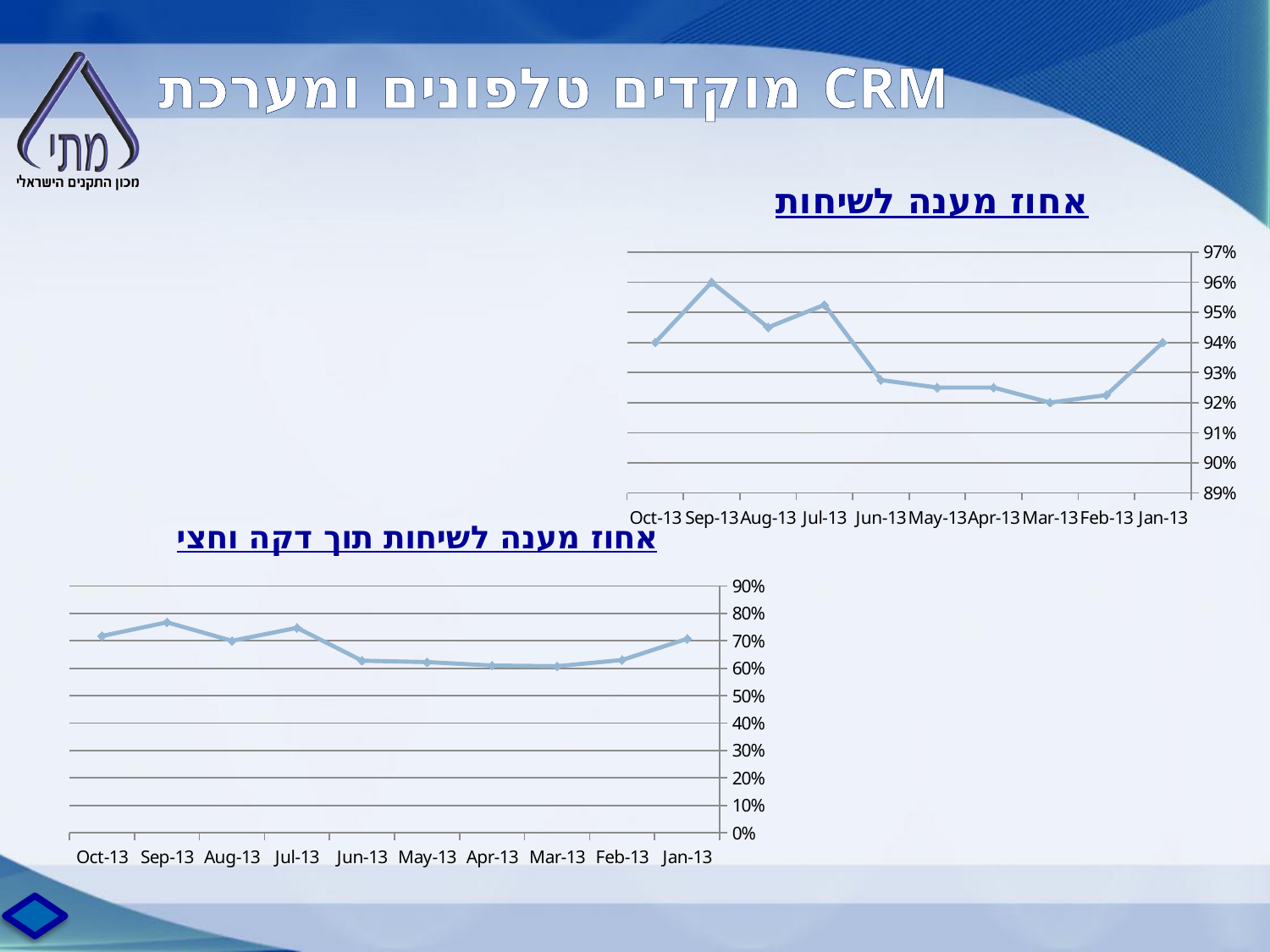
In the top chart (אחוז מענה לשיחות), does the value rise or fall from Jul-13 to Jun-13? fall What is the highest value shown on the vertical axis of the bottom chart (אחוז מענה לשיחות תוך דקה וחצי)? 90% In the bottom chart (אחוז מענה לשיחות תוך דקה וחצי), is the value for Apr-13 greater or less than 70%? less In the top chart (אחוז מענה לשיחות), is the value for Jul-13 greater or less than 95%? greater What kind of chart is the top chart titled "אחוז מענה לשיחות"? line chart In the bottom chart (אחוז מענה לשיחות תוך דקה וחצי), which is larger, the value for Jul-13 or the value for Jun-13? Jul-13 In the top chart (אחוז מענה לשיחות), which month has the lowest value? Mar-13 In the top chart (אחוז מענה לשיחות), which month has the highest value? Sep-13 How many months are plotted on the top chart (אחוז מענה לשיחות)? 10 In the bottom chart (אחוז מענה לשיחות תוך דקה וחצי), is the value for Sep-13 greater or less than 70%? greater In the top chart (אחוז מענה לשיחות), which is larger, the value for Sep-13 or the value for May-13? Sep-13